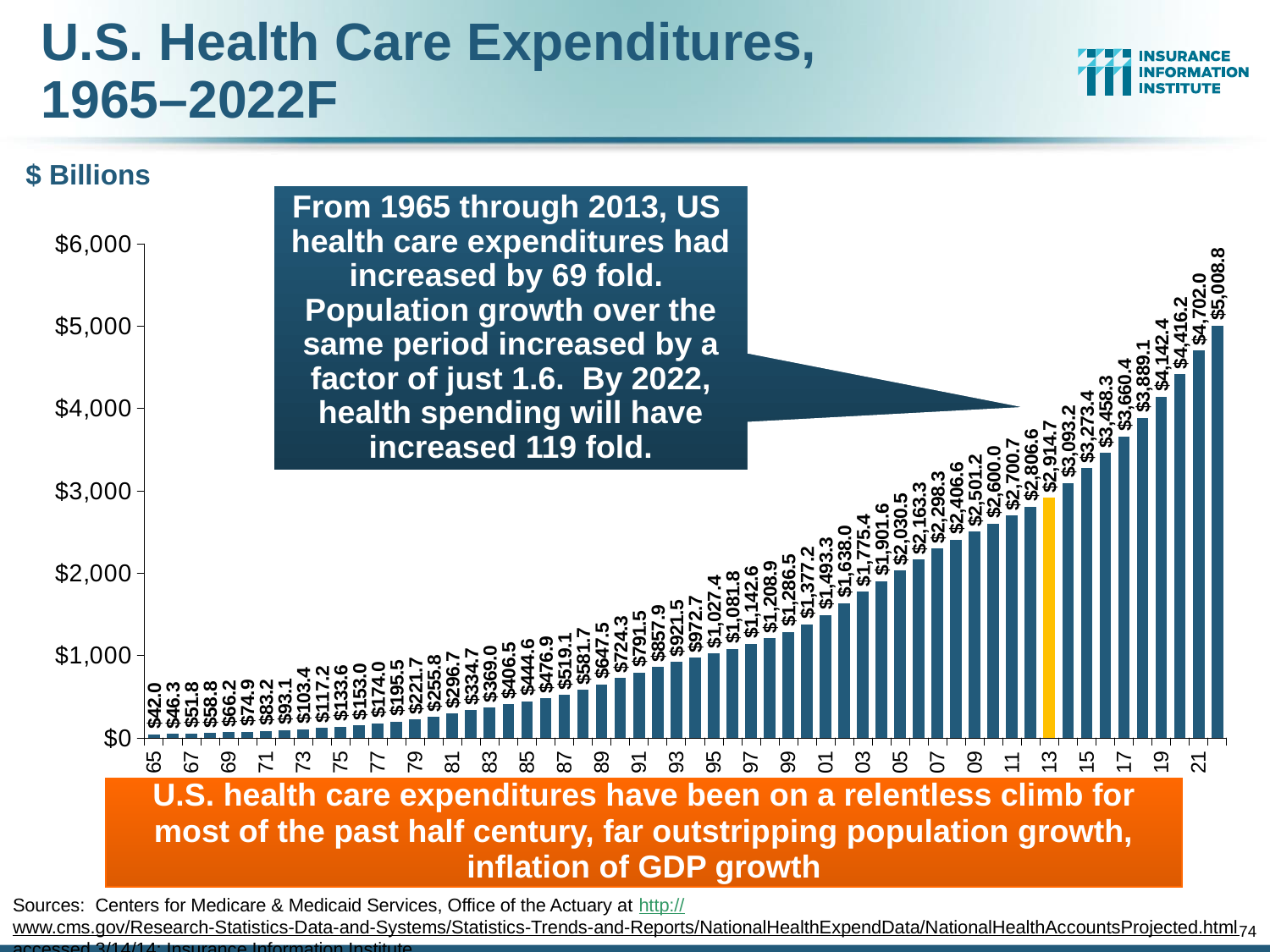
Which year's bar is highlighted in a different colour (yellow) from the rest? 2013 What is the forecast value for U.S. health care expenditures in 2022? $5,008.8 What kind of chart is shown on the slide? Bar chart Which year has the highest value on the chart? 2022 Do the values generally rise or fall from 1965 to 2022? Rise Which year has the lowest value on the chart? 1965 What unit is shown for the y-axis of the chart? $ Billions What is the difference between the 2022 value and the 2013 value? $2,094.1 What were U.S. health care expenditures in 1965? $42.0 Which is larger, the value for 2000 or the value for 1990? 2000 What were U.S. health care expenditures in 2013, according to the chart? $2,914.7 Is the value for 2010 greater or less than $2,000? greater